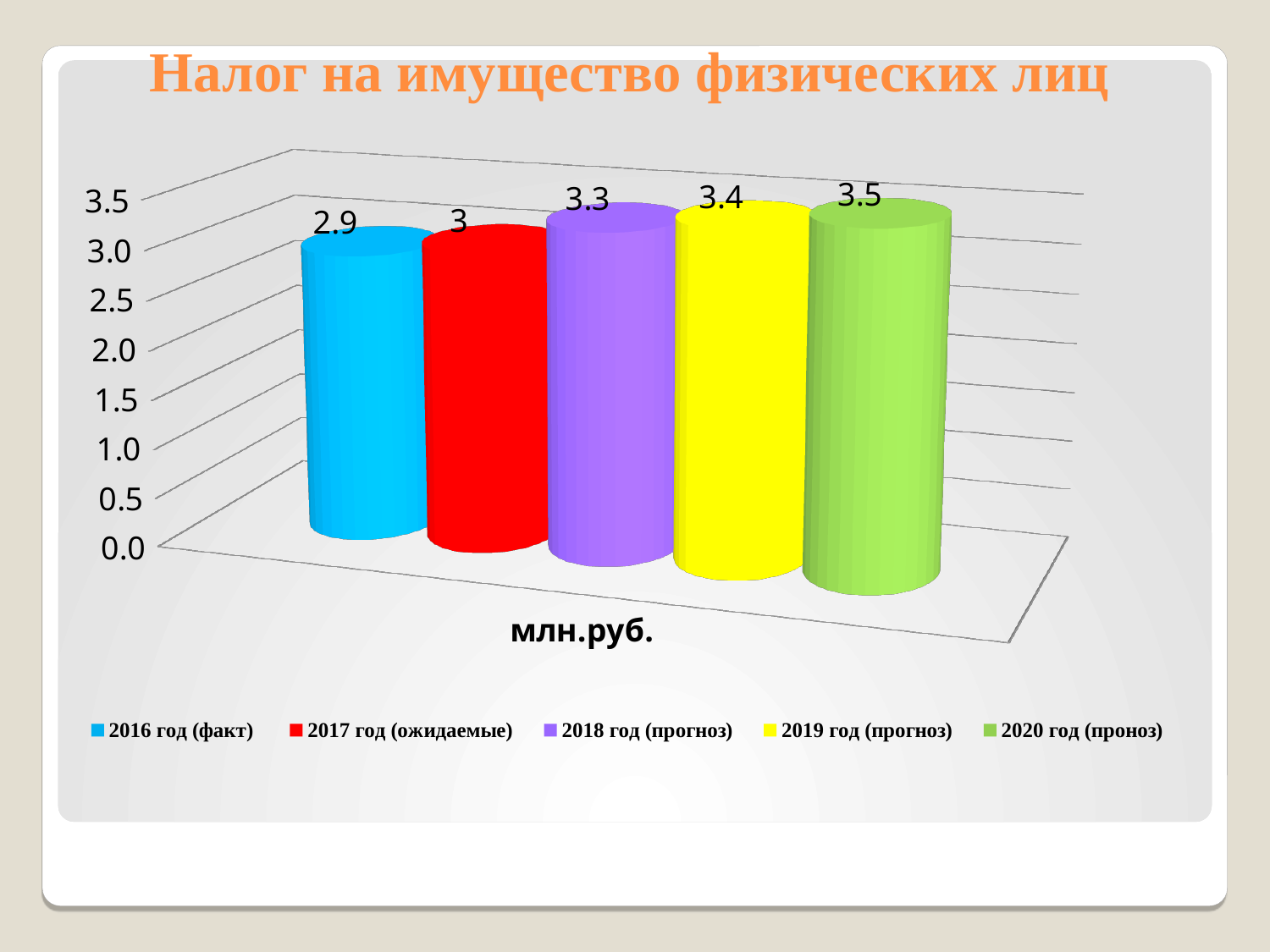
How many entries does the legend list? 5 Which year has the highest value? 2020 год (проноз) What kind of chart is shown on the slide? bar chart What is the value for 2016 год (факт)? 2.9 What is the value for 2017 год (ожидаемые)? 3 What is the value for 2020 год (проноз)? 3.5 Which year has the lowest value? 2016 год (факт) What is the value for 2018 год (прогноз)? 3.3 What is the difference between the values for 2020 год (проноз) and 2016 год (факт)? 0.6 Do the values rise or fall from 2016 to 2020? rise Which is larger, the value for 2018 год (прогноз) or 2017 год (ожидаемые)? 2018 год (прогноз) How many bars are shown in the chart? 5